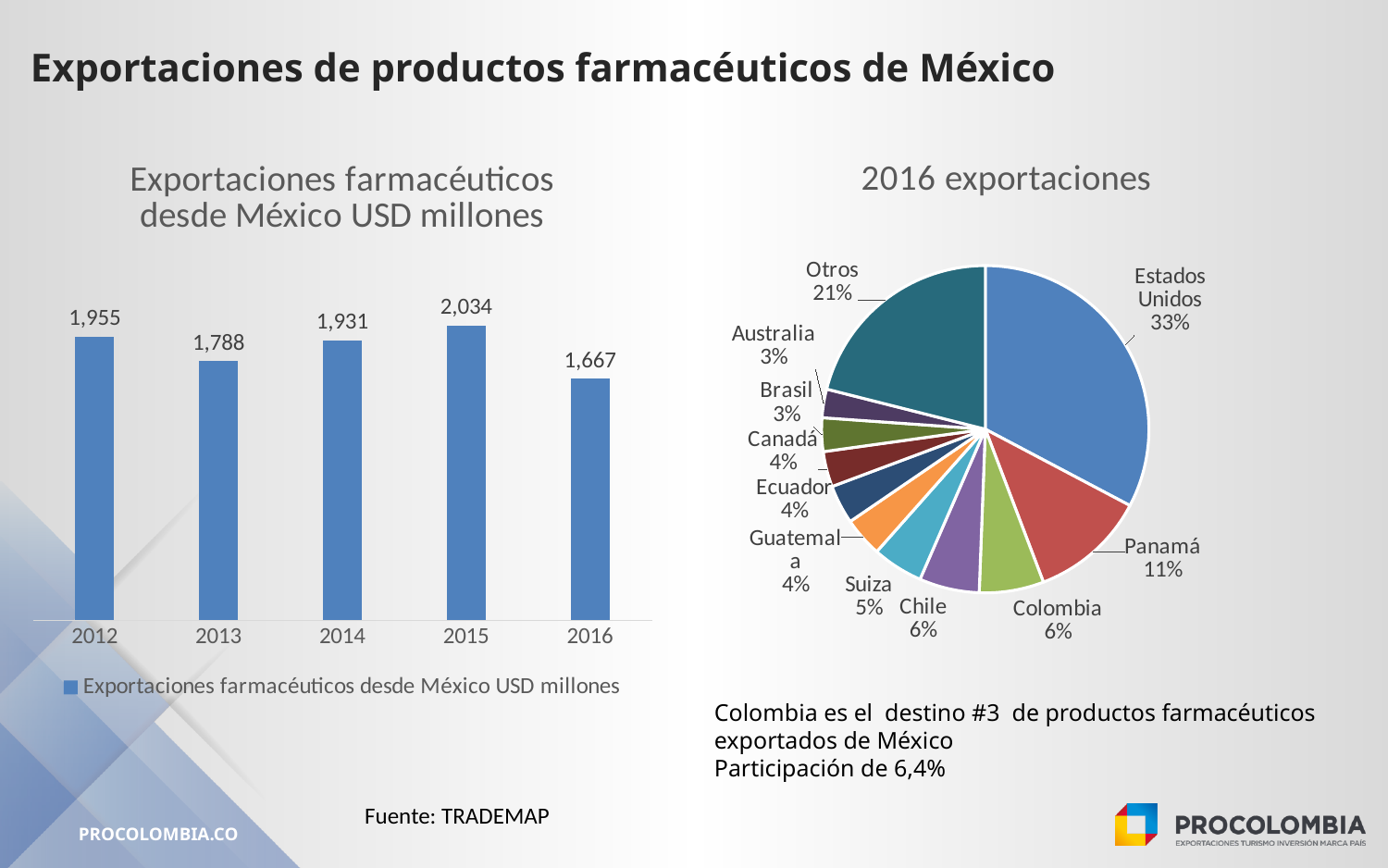
How many years are shown in the bar chart 'Exportaciones farmacéuticos desde México USD millones'? 5 In the bar chart 'Exportaciones farmacéuticos desde México USD millones', which year has the highest value? 2015 In the bar chart 'Exportaciones farmacéuticos desde México USD millones', which year has the lowest value? 2016 How many slices does the pie chart '2016 exportaciones' have? 11 In the bar chart 'Exportaciones farmacéuticos desde México USD millones', which is larger, the value for 2012 or the value for 2014? 2012 In the pie chart '2016 exportaciones', what share does Panamá have? 11% In the bar chart 'Exportaciones farmacéuticos desde México USD millones', what is the value for 2013? 1,788 In the pie chart '2016 exportaciones', what share does Estados Unidos have? 33% In the bar chart 'Exportaciones farmacéuticos desde México USD millones', what is the value for 2015? 2,034 What kind of chart is the chart on the left of the slide? Bar chart In the pie chart '2016 exportaciones', which named country has the largest slice? Estados Unidos In the bar chart 'Exportaciones farmacéuticos desde México USD millones', what is the difference between the values for 2015 and 2016? 367